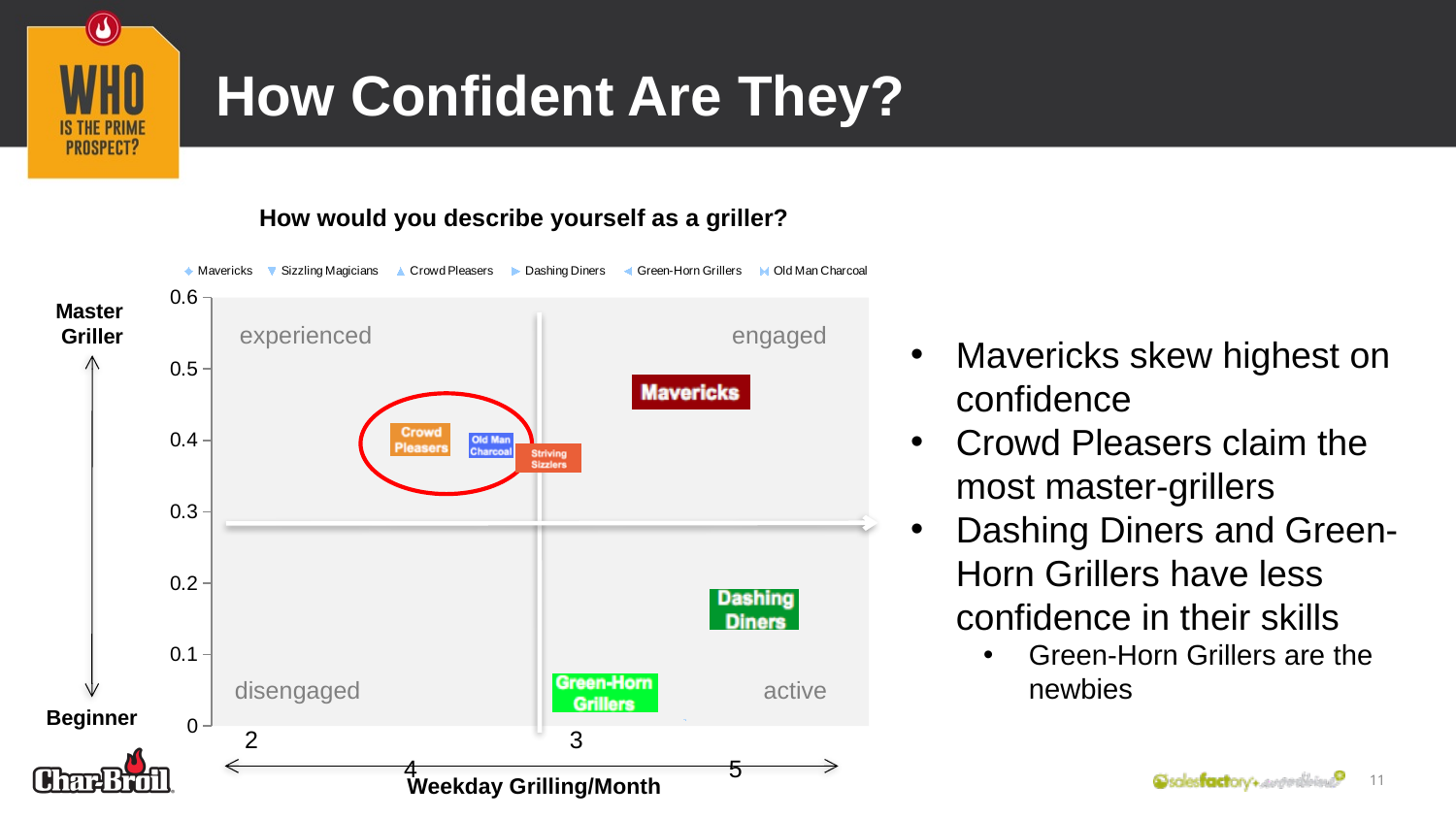
What kind of chart is shown on the slide? scatter chart What is the title of the chart? How would you describe yourself as a griller? Is the vertical-axis value for Crowd Pleasers greater or less than 0.3? greater How many series does the chart legend list? 6 Is the vertical-axis value for Mavericks greater or less than 0.4? greater Which is plotted higher on the vertical axis, Mavericks or Dashing Diners? Mavericks What is the label of the horizontal axis of the chart? Weekday Grilling/Month Which is plotted higher on the vertical axis, Old Man Charcoal or Green-Horn Grillers? Old Man Charcoal Is the vertical-axis value for Green-Horn Grillers greater or less than 0.1? less Which segment is plotted highest on the vertical (Master Griller) axis? Mavericks Which segment is plotted lowest on the vertical (Master Griller) axis? Green-Horn Grillers